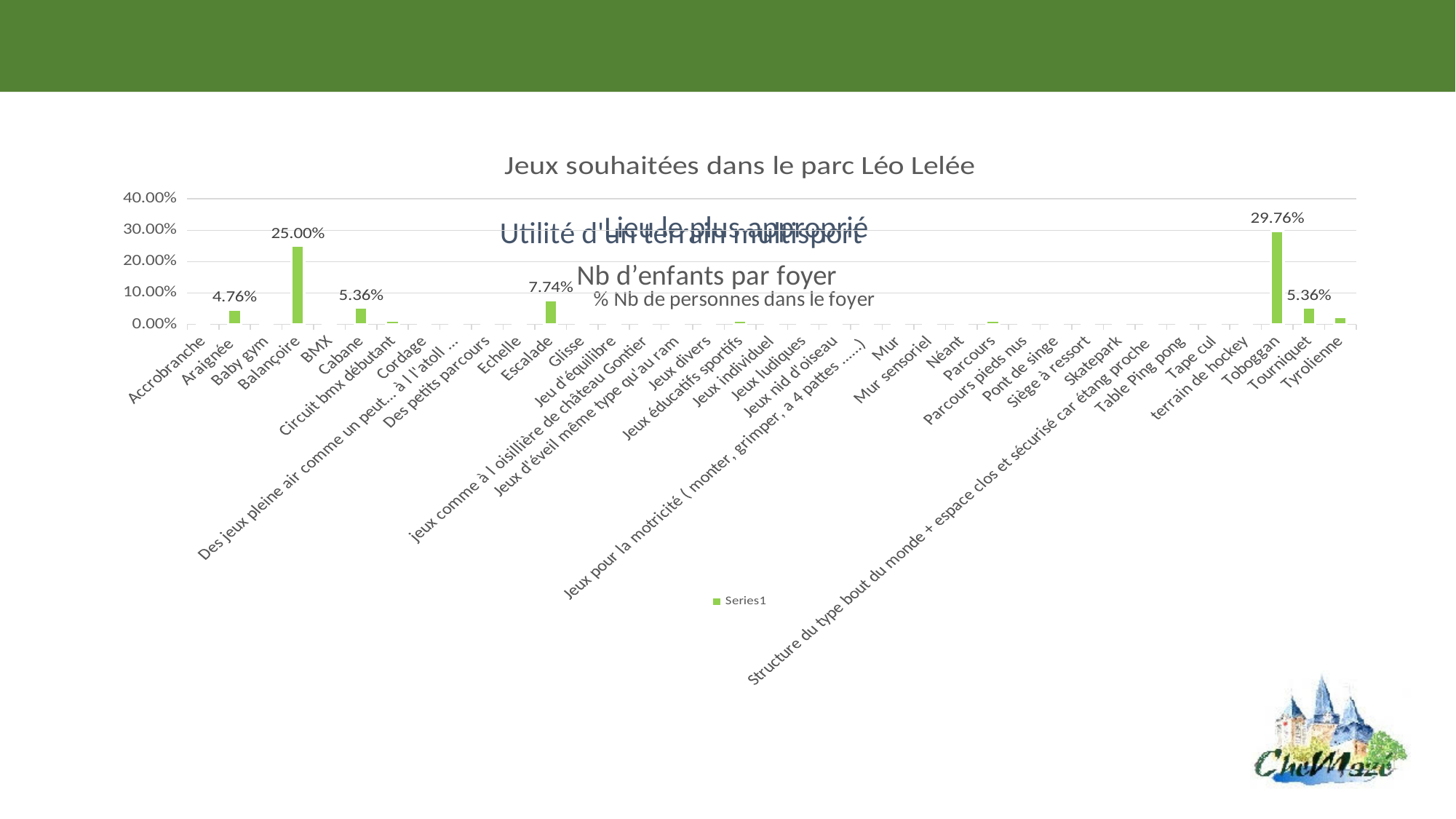
What is the value for Toboggan in the chart 'Jeux souhaitées dans le parc Léo Lelée'? 29.76% What is the value for Escalade? 7.74% How many series does the legend list? 1 What kind of chart is shown on the slide? Bar chart What is the value for Tourniquet? 5.36% What is the difference between the values for Toboggan and Balançoire? 4.76% Which category has the highest value in the chart? Toboggan What is the value for Balançoire? 25.00% Which is larger, the value for Escalade or the value for Cabane? Escalade What is the value for Araignée? 4.76% What is the title of the chart? Jeux souhaitées dans le parc Léo Lelée Is the value for Balançoire greater or less than 20.00%? greater